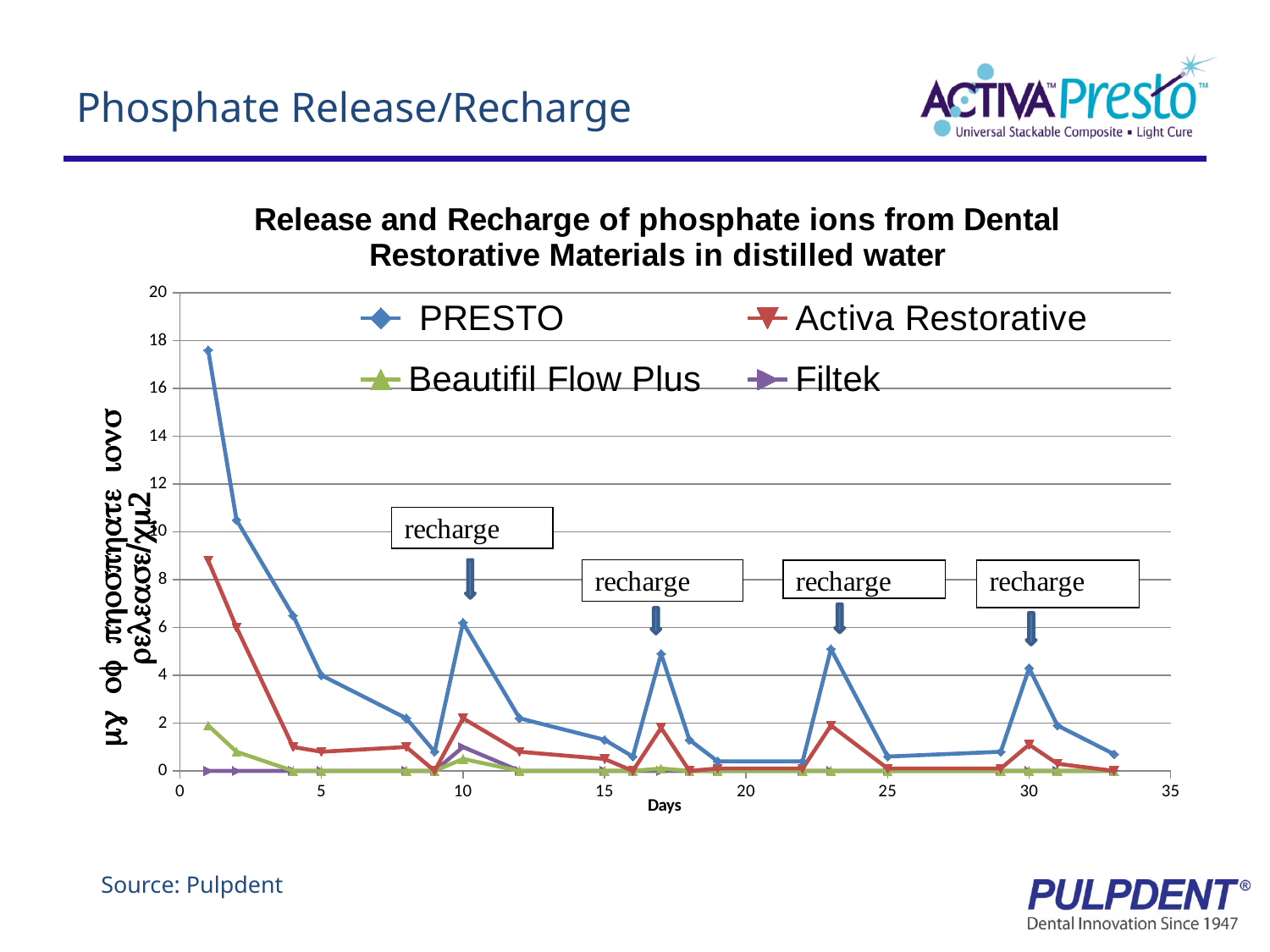
Is the value for PRESTO at day 1 greater or less than 16? greater What kind of chart is shown on the slide? line chart Is the value for Activa Restorative at day 1 greater or less than 8? greater Is the value for Filtek at day 1 greater or less than 2? less At day 1, which is larger: the value for PRESTO or the value for Activa Restorative? PRESTO What is the title of the chart? Release and Recharge of phosphate ions from Dental Restorative Materials in distilled water How many 'recharge' annotations are marked on the chart? 4 How many series does the chart legend list? 4 What is the label of the x axis? Days Does the PRESTO line rise or fall between day 1 and day 9? fall Which series reaches the highest value on the chart? PRESTO